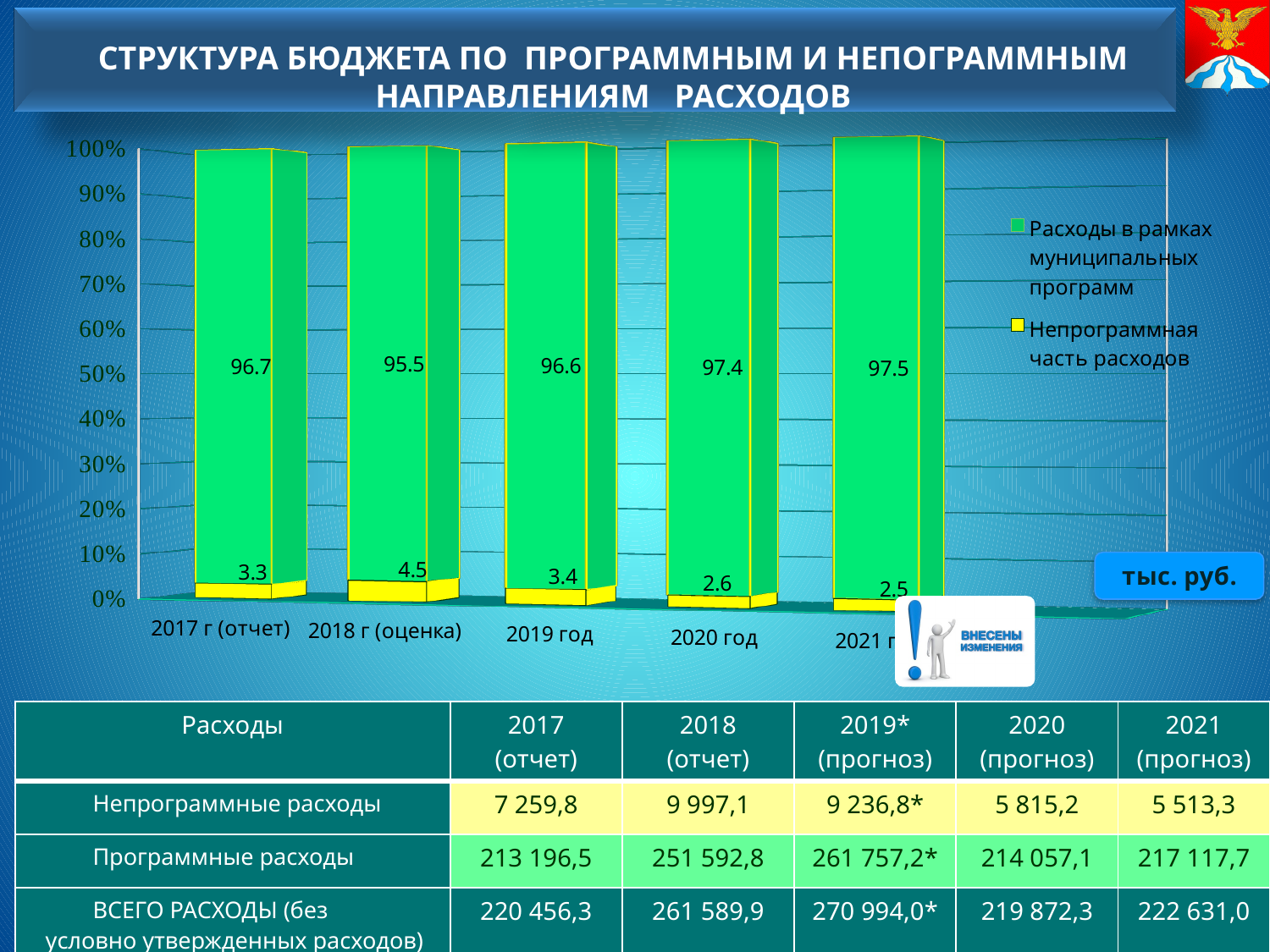
What is the total of the stacked bar for 2021? 100 In which year is the yellow series (Непрограммная часть расходов) highest? 2018 г (оценка) What is the value of the green series for 2020 год? 97.4 What type of chart is shown on the slide? Stacked bar chart How many series does the chart legend list? 2 Which is larger: the yellow series value for 2017 г (отчет) or for 2020 год? 2017 г (отчет) What is the difference between the yellow series values for 2018 г (оценка) and 2021? 2.0 In which year is the green series (Расходы в рамках муниципальных программ) lowest? 2018 г (оценка) How many years (categories) are shown on the x axis of the chart? 5 What is the value of the green series (Расходы в рамках муниципальных программ) for 2017 г (отчет)? 96.7 What is the value of the yellow series for 2019 год? 3.4 What is the value of the yellow series (Непрограммная часть расходов) for 2018 г (оценка)? 4.5